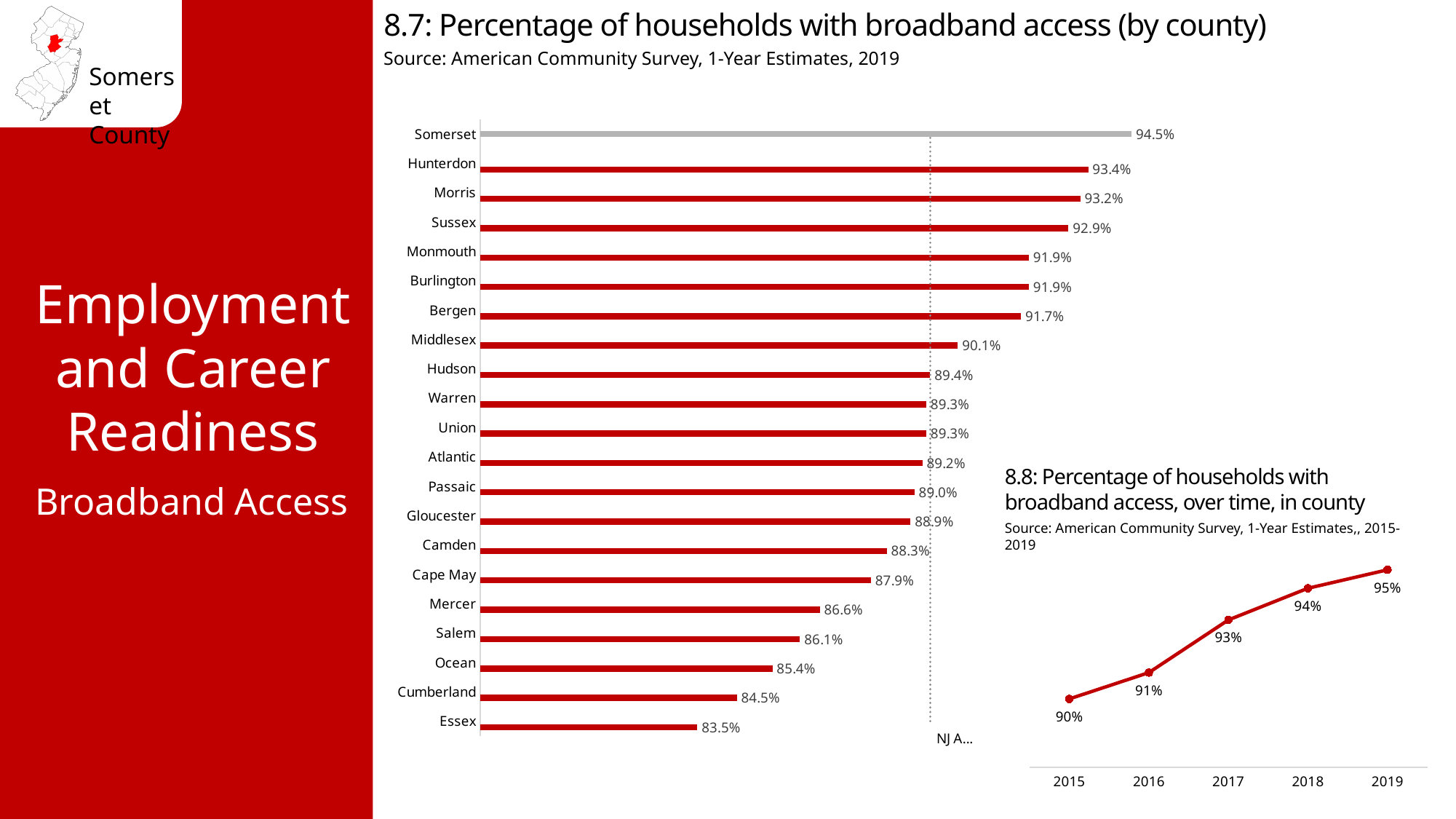
What kind of chart is chart 8.7 (by county)? Bar chart In chart 8.7 (by county), which has a higher value, Mercer or Ocean? Mercer In chart 8.8 (over time, in county), what is the value for 2017? 93% In chart 8.7 (by county), what is the difference between Somerset's value and Essex's value? 11.0% In chart 8.7 (Percentage of households with broadband access by county), what is the value for Somerset? 94.5% In chart 8.7 (by county), which county has the highest percentage of households with broadband access? Somerset In chart 8.7 (by county), how many counties are shown? 21 In chart 8.8 (over time, in county), do the values rise or fall from 2015 to 2019? Rise What kind of chart is chart 8.8 (over time, in county)? Line chart In chart 8.7 (by county), what is the value for Middlesex? 90.1% In chart 8.7 (by county), which county has the lowest percentage of households with broadband access? Essex In chart 8.8 (over time, in county), what is the difference between the 2019 value and the 2015 value? 5%